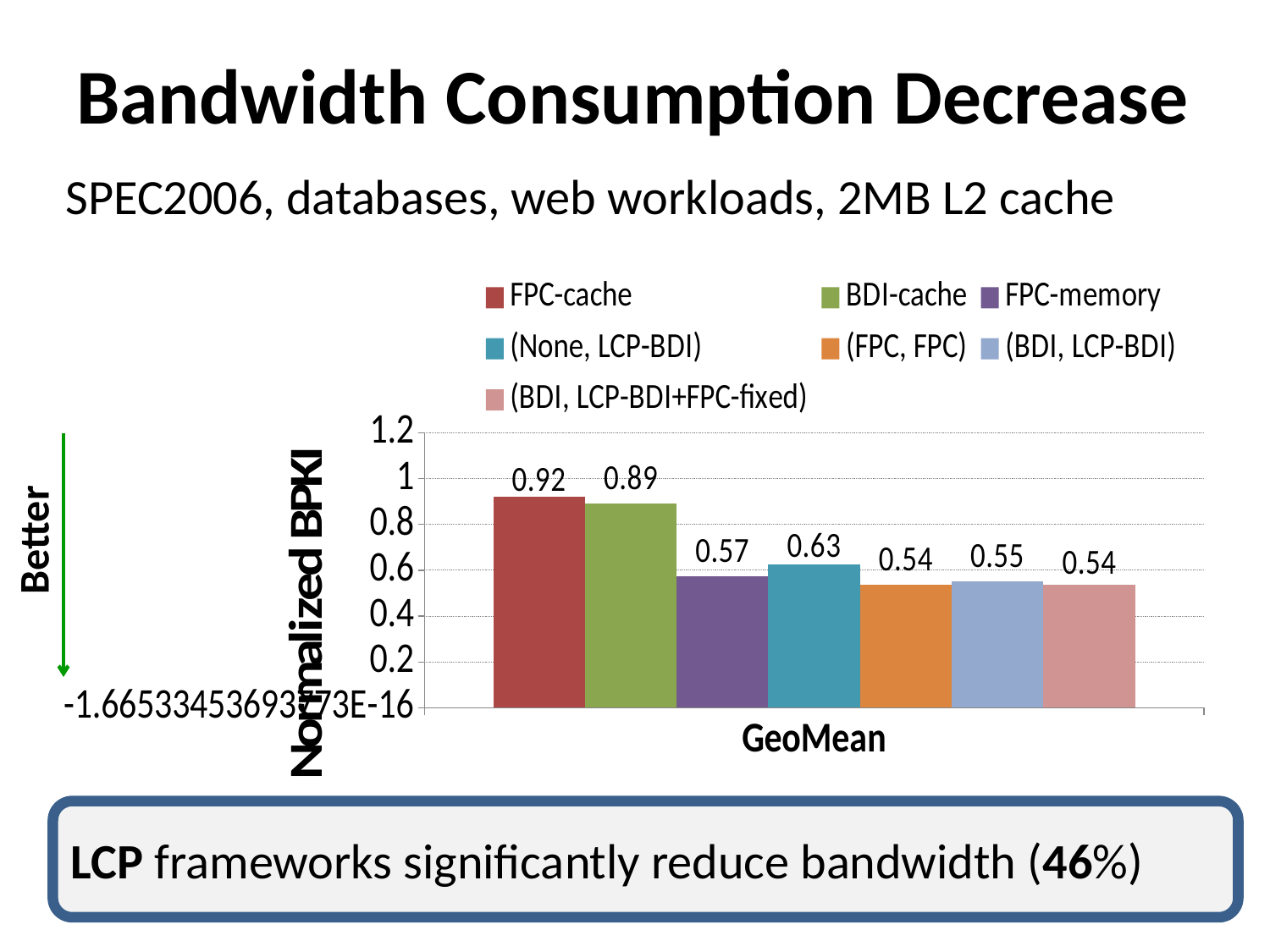
What is the Normalized BPKI value for (BDI, LCP-BDI) at GeoMean? 0.55 How many series does the legend list? 7 What is the difference between the FPC-cache and (FPC, FPC) values at GeoMean? 0.38 What is the label on the vertical axis of the chart? Normalized BPKI What is the Normalized BPKI value for FPC-cache at GeoMean? 0.92 What is the Normalized BPKI value for FPC-memory at GeoMean? 0.57 What is the Normalized BPKI value for (None, LCP-BDI) at GeoMean? 0.63 Is the value for BDI-cache greater or less than 0.8? greater Which series has the highest Normalized BPKI at GeoMean? FPC-cache Which is larger at GeoMean: FPC-memory or (None, LCP-BDI)? (None, LCP-BDI) What kind of chart is shown on the slide? bar chart What is the Normalized BPKI value for BDI-cache at GeoMean? 0.89